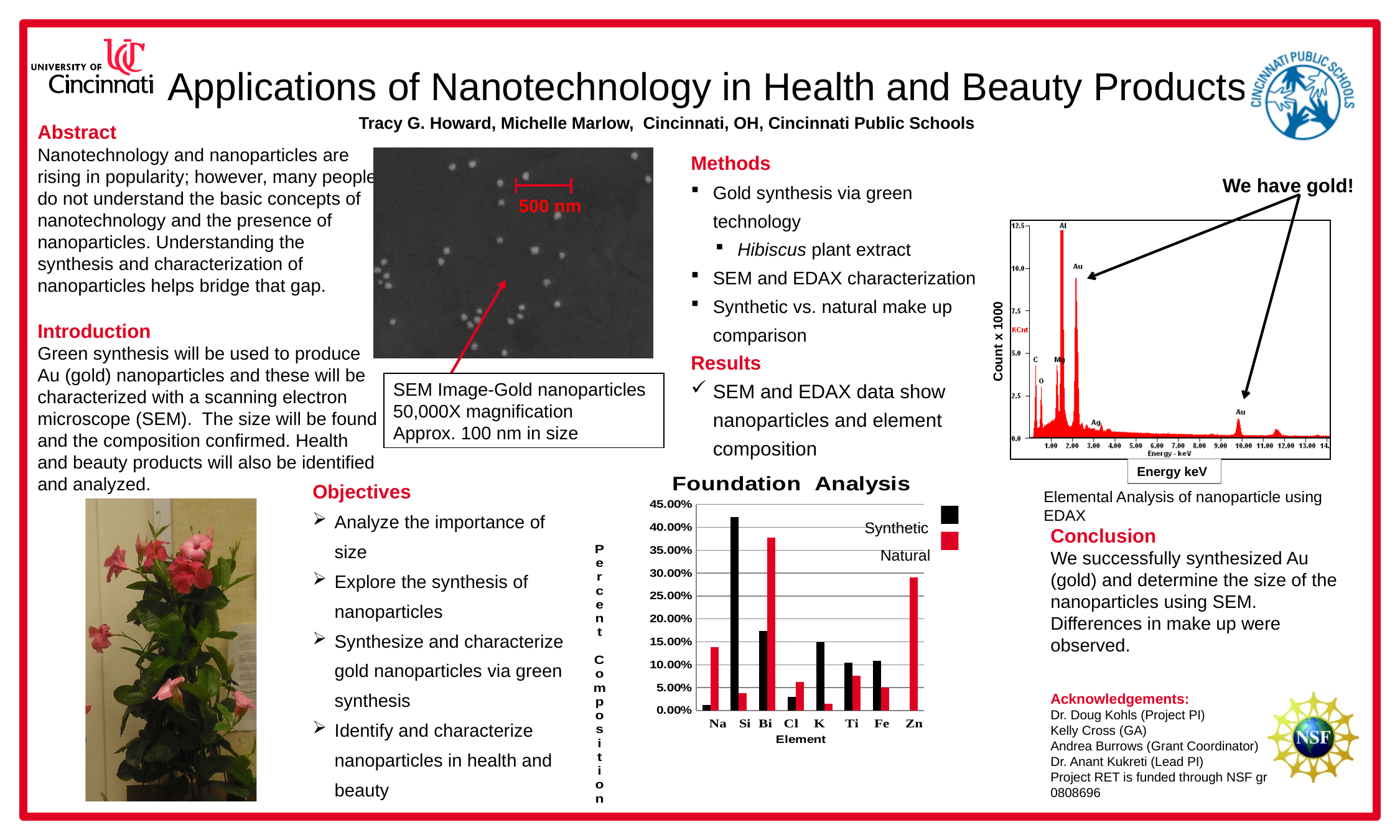
How many elements are shown on the x axis of the Foundation Analysis chart? 8 In the Foundation Analysis chart, is the Synthetic or the Natural value larger for Si? Synthetic How many series does the legend of the Foundation Analysis chart list? 2 What kind of chart is the Foundation Analysis chart? bar chart In the Foundation Analysis chart, which element has the highest Synthetic value? Si In the Foundation Analysis chart, which element has the highest Natural value? Bi In the Foundation Analysis chart, is the Synthetic or the Natural value larger for Bi? Natural In the Foundation Analysis chart, is the Natural value for Zn greater or less than 25.00%? greater In the Foundation Analysis chart, which element has the lowest Synthetic value? Zn In the Foundation Analysis chart, is the Synthetic value for Si greater or less than 40.00%? greater In the Foundation Analysis chart, is the Natural value for K greater or less than 5.00%? less In the Foundation Analysis chart, which colour represents the Natural series? red